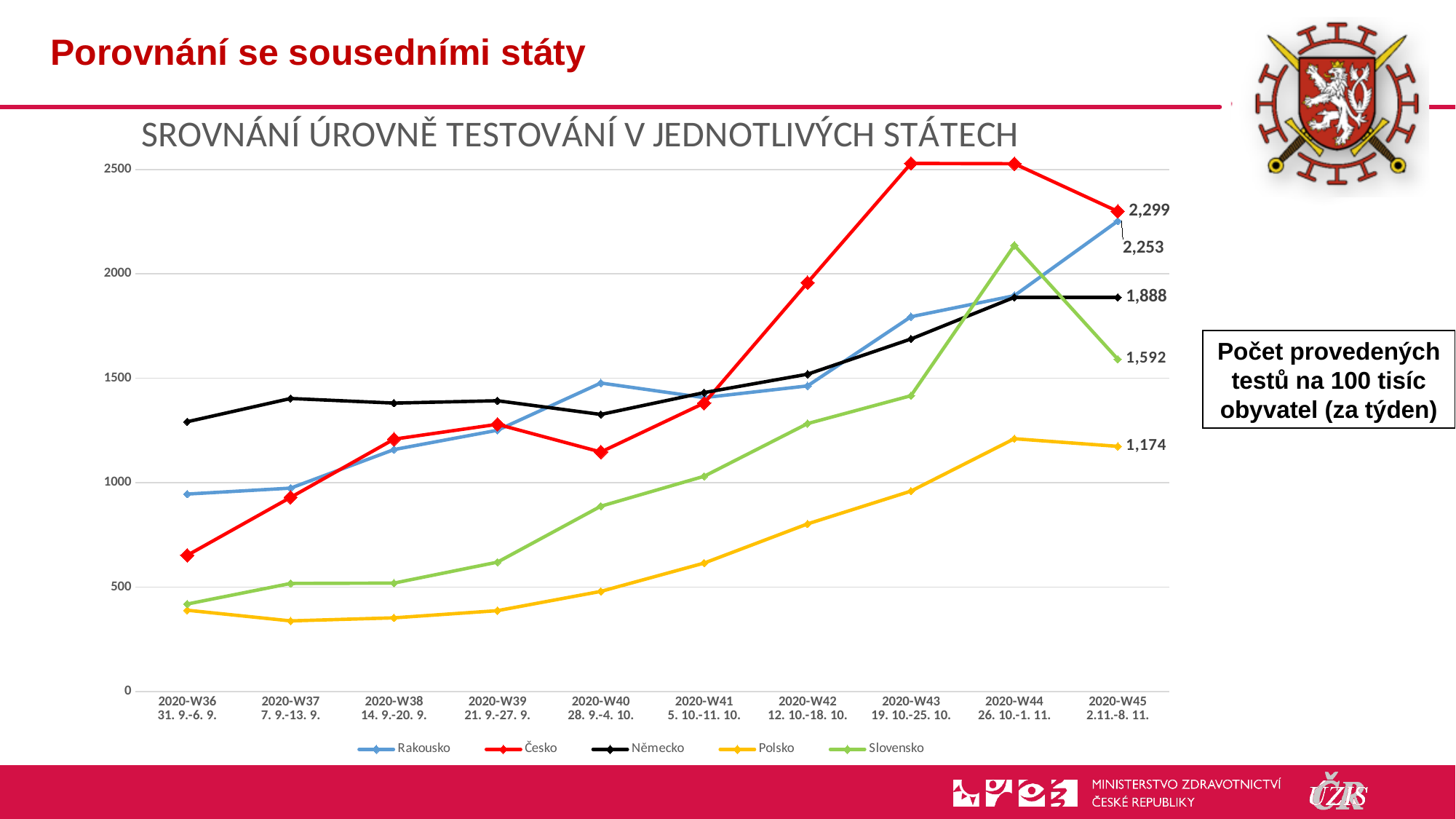
In week 2020-W45, what is the difference between Německo and Slovensko? 296 What kind of chart is shown on the slide? line chart Which country has the highest value in week 2020-W45? Česko Which country has the lowest value in week 2020-W45? Polsko How many weeks are shown on the x axis? 10 Which is larger in week 2020-W36, the value for Německo or the value for Rakousko? Německo What is the value for Německo in week 2020-W45? 1,888 Is the value for Slovensko in week 2020-W44 greater or less than 2000? greater How many series does the legend list? 5 What is the value for Česko in week 2020-W45? 2,299 What is the value for Polsko in week 2020-W45? 1,174 In week 2020-W45, how much higher is Česko than Rakousko? 46